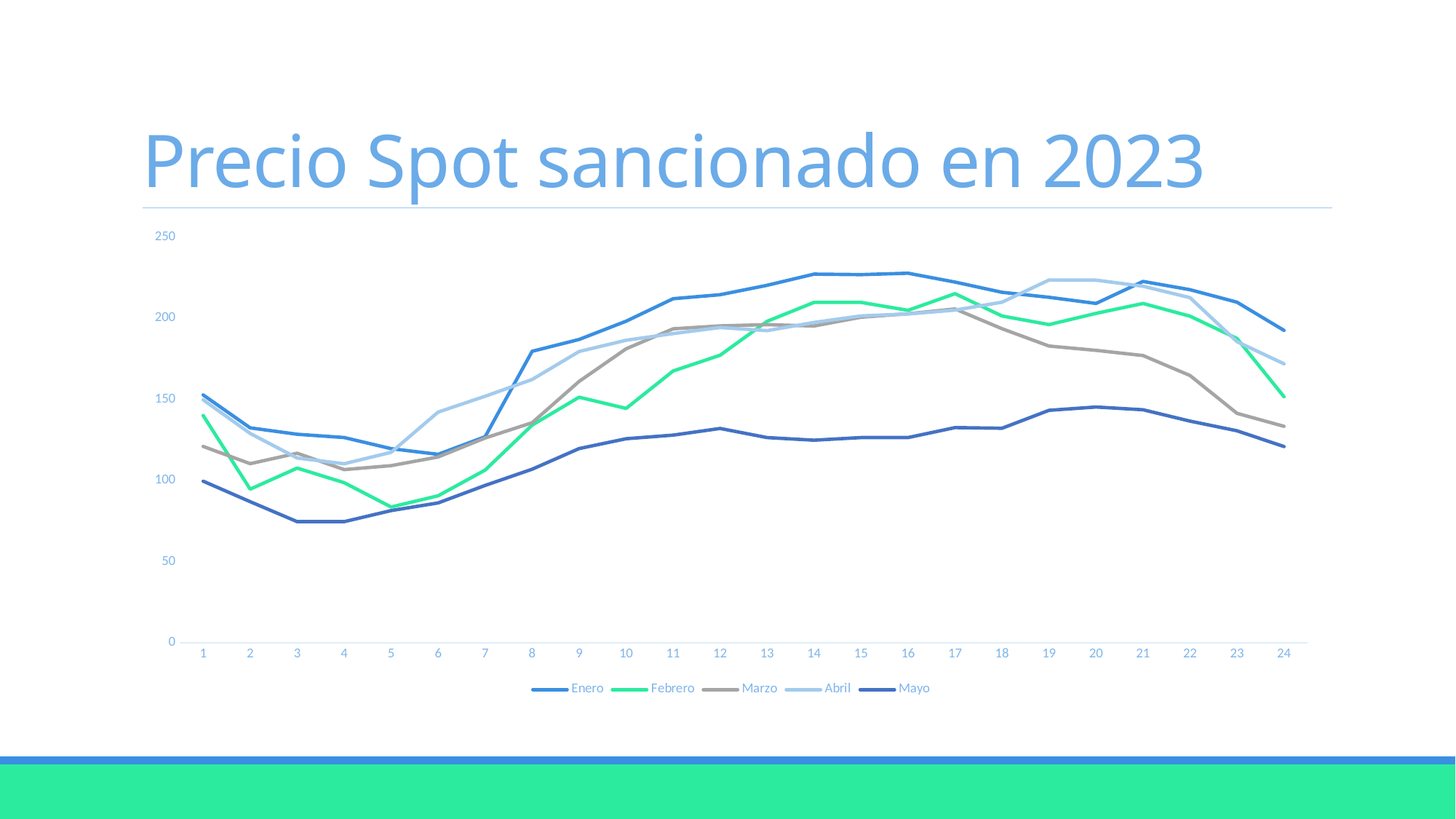
Is the value for Enero at point 14 greater or less than 200? greater Which series has the lowest value at point 14? Mayo Does the Mayo line rise or fall from point 1 to point 4? fall Is the value for Mayo at point 4 greater or less than 100? less What is the title of the chart? Precio Spot sancionado en 2023 What kind of chart is shown on the slide? line chart Is the value for Abril at point 19 greater or less than 200? greater How many points are plotted along the x axis for each series? 24 Which series is drawn in green in the legend? Febrero How many series does the legend list? 5 At point 8, which is larger: Enero or Mayo? Enero